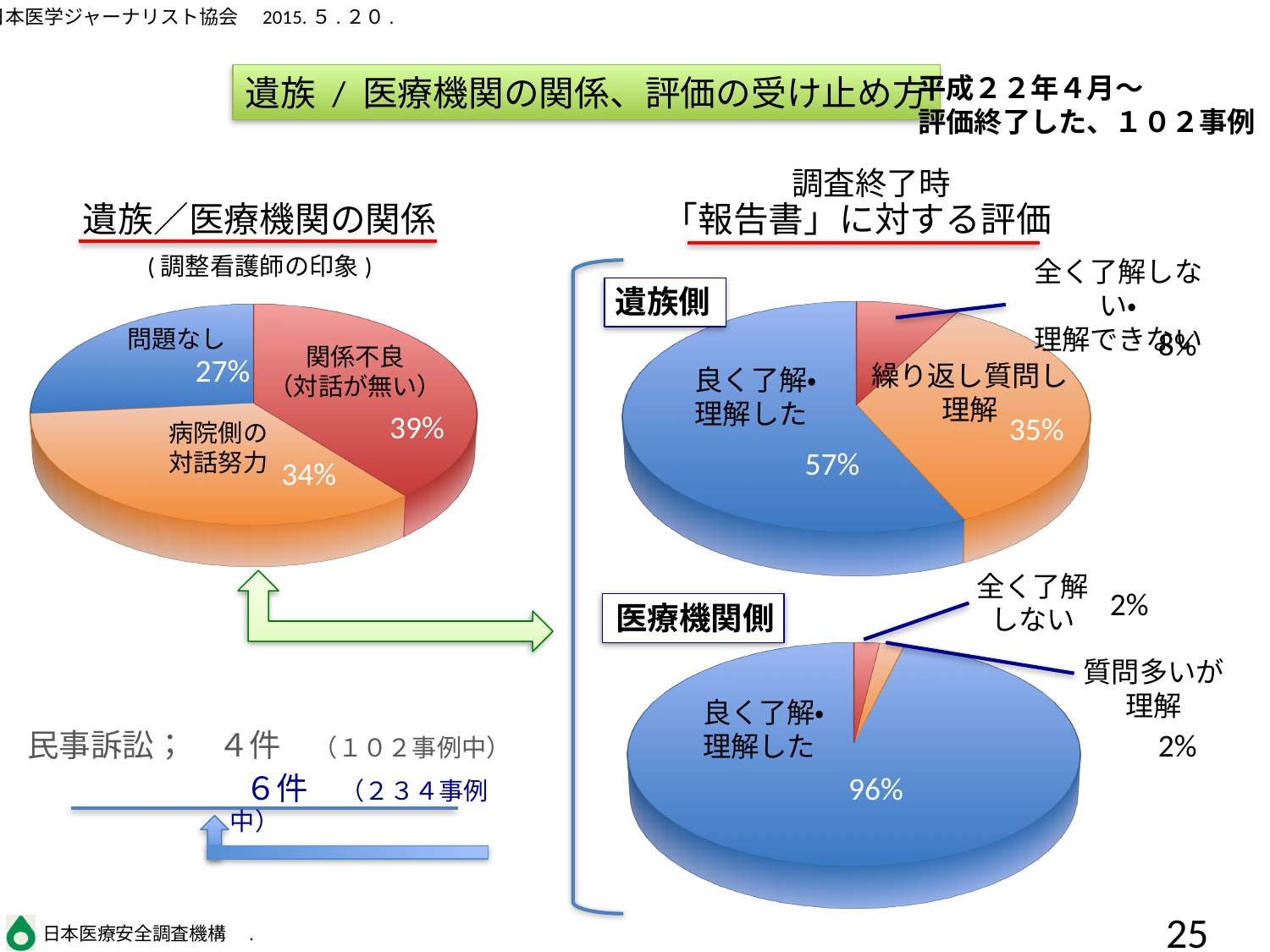
左側の「遺族／医療機関の関係」の円グラフで、最も割合が小さい項目はどれですか？ 問題なし 左側の「遺族／医療機関の関係」の円グラフで、最も割合が大きい項目はどれですか？ 関係不良（対話が無い） 右上の「遺族側」の円グラフで、「全く了解しない・理解できない」の割合はいくつですか？ 8% 左側の「遺族／医療機関の関係」の円グラフで、「関係不良（対話が無い）」の割合はいくつですか？ 39% 「良く了解・理解した」の割合は、「遺族側」と「医療機関側」のどちらが大きいですか？ 医療機関側 左側の「遺族／医療機関の関係」の円グラフには、いくつの項目がありますか？ 3 左側の「遺族／医療機関の関係」の円グラフで、「関係不良（対話が無い）」と「病院側の対話努力」の差は何ポイントですか？ 5% 左側の「遺族／医療機関の関係」の円グラフで、「問題なし」の割合はいくつですか？ 27% 右上の「遺族側」の円グラフで、「良く了解・理解した」の割合はいくつですか？ 57% 右下の「医療機関側」の円グラフで、「良く了解・理解した」の割合はいくつですか？ 96% 右上の「遺族側」の円グラフで、「繰り返し質問し理解」の割合はいくつですか？ 35% このスライドのグラフはどの種類のグラフですか？ 円グラフ